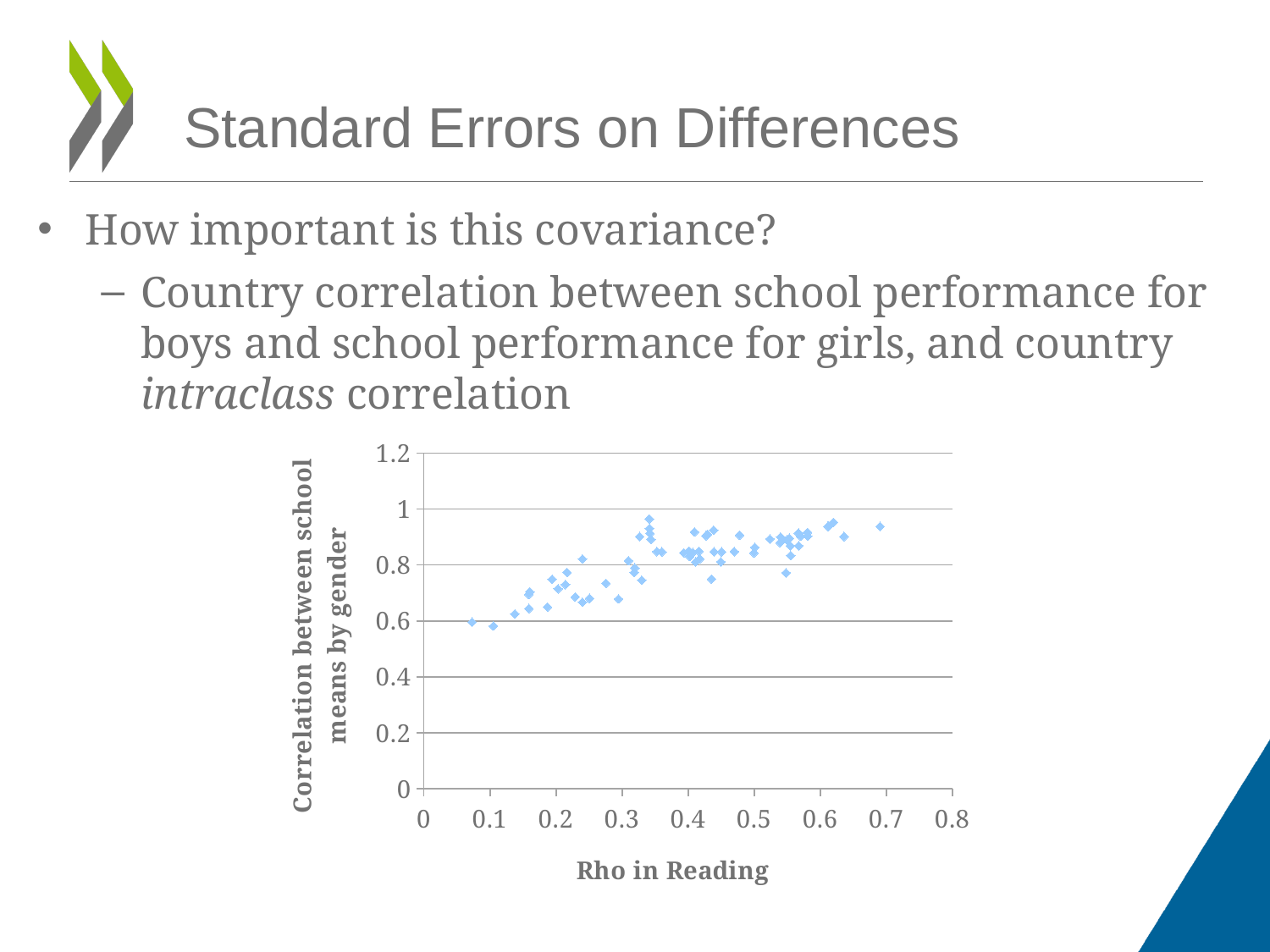
Are all the plotted points' y values greater or less than 0.4? greater Are all the plotted points' x values greater or less than 0.8? less Is the y value of the point with the lowest Rho in Reading greater or less than 0.8? less What is the title of the y axis of the chart? Correlation between school means by gender What is the maximum value shown on the y axis? 1.2 What is the title of the x axis of the chart? Rho in Reading What kind of chart is shown on the slide? scatter chart As Rho in Reading increases along the x axis, does the correlation between school means by gender generally rise or fall? rise